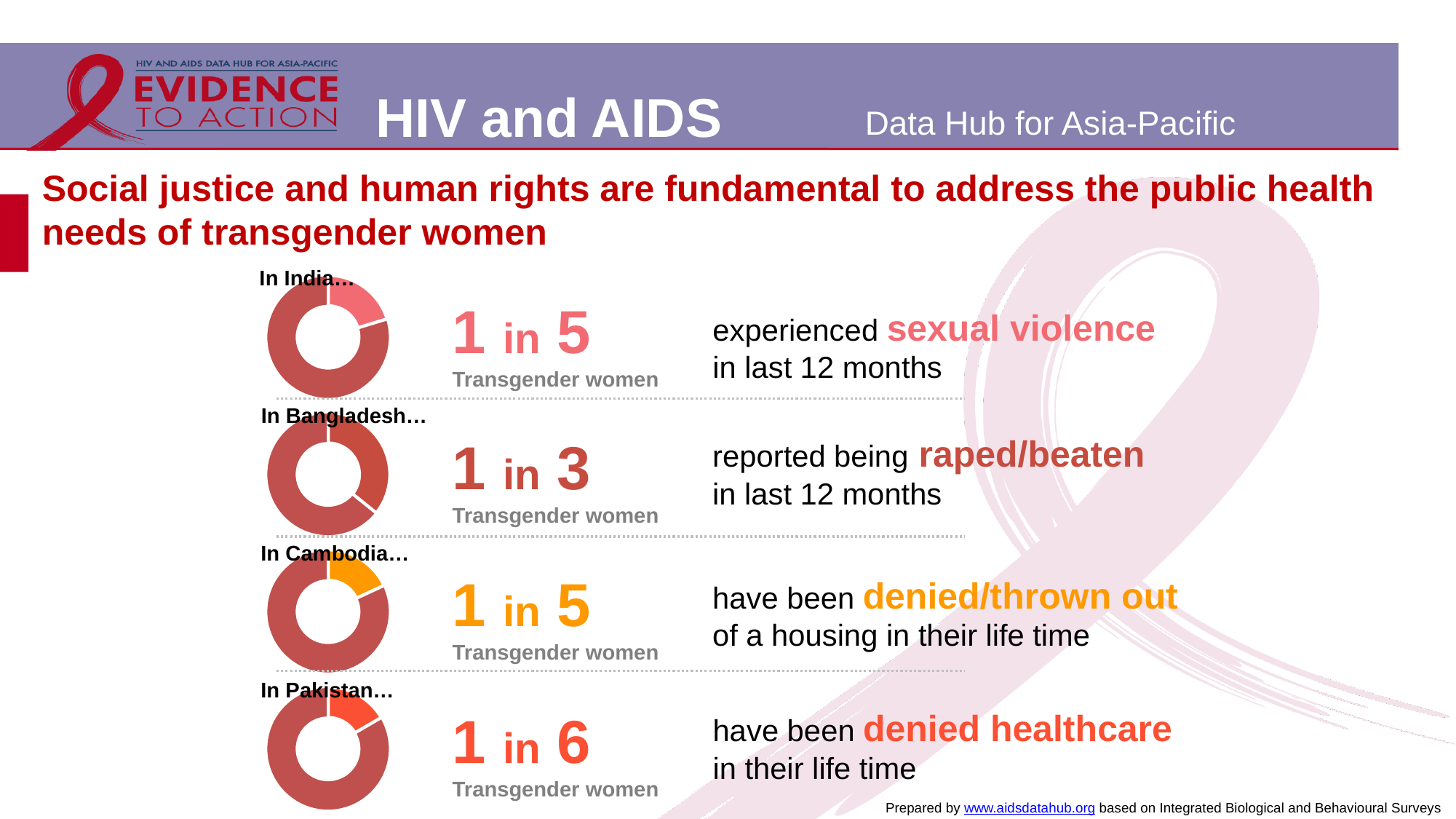
Is the highlighted share larger in the India chart or the Bangladesh chart? Bangladesh Which country's chart shows the largest highlighted share? Bangladesh In the India chart, what proportion of transgender women experienced sexual violence in the last 12 months? 1 in 5 Is the highlighted share larger in the Bangladesh chart or the Pakistan chart? Bangladesh In the Bangladesh chart, what proportion of transgender women reported being raped/beaten in the last 12 months? 1 in 3 What colour is the highlighted slice in the Cambodia chart? Orange In the Cambodia chart, what proportion of transgender women have been denied/thrown out of housing in their lifetime? 1 in 5 Which country's chart relates to transgender women being denied healthcare in their lifetime? Pakistan How many donut charts are shown on the slide? 4 What kind of chart is used for each country on this slide? Donut (pie) chart Which country's chart shows the smallest highlighted share? Pakistan In the Pakistan chart, what proportion of transgender women have been denied healthcare in their lifetime? 1 in 6